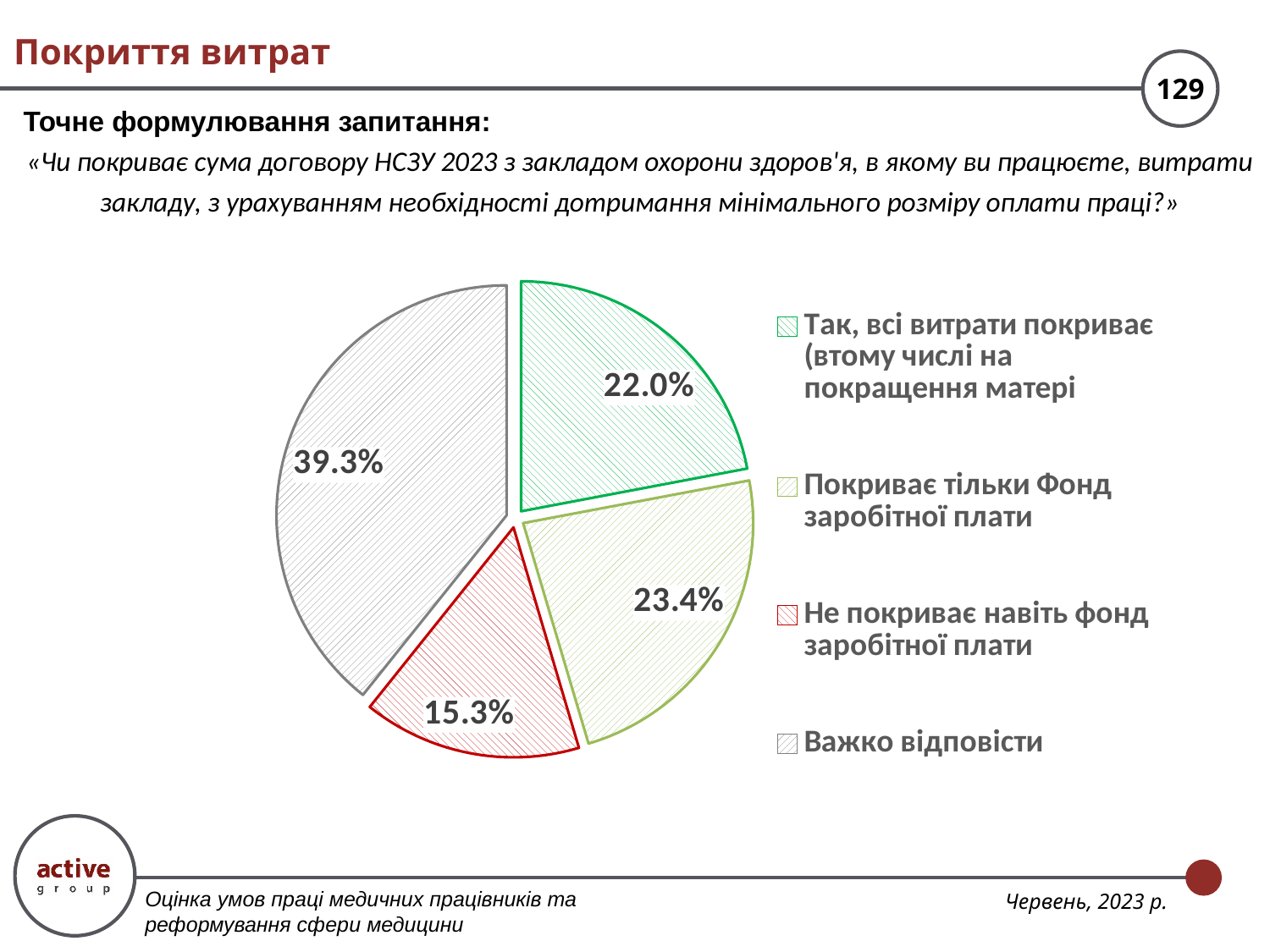
What kind of chart is shown on the slide? pie chart What is the difference in percentage points between the "Важко відповісти" slice and the "Не покриває навіть фонд заробітної плати" slice? 24.0 What share of the pie is labelled "Не покриває навіть фонд заробітної плати"? 15.3% Which category has the largest slice of the pie? Важко відповісти What share of the pie is labelled "Важко відповісти"? 39.3% What colour is the outline of the "Не покриває навіть фонд заробітної плати" slice? red How many entries does the legend of the pie chart list? 4 What share of the pie is labelled "Покриває тільки Фонд заробітної плати"? 23.4% How many slices does the pie chart have? 4 Which is larger: the slice for "Покриває тільки Фонд заробітної плати" or the slice for "Не покриває навіть фонд заробітної плати"? Покриває тільки Фонд заробітної плати What share of the pie is labelled "Так, всі витрати покриває (втому числі на покращення матері"? 22.0% Which category has the smallest slice of the pie? Не покриває навіть фонд заробітної плати